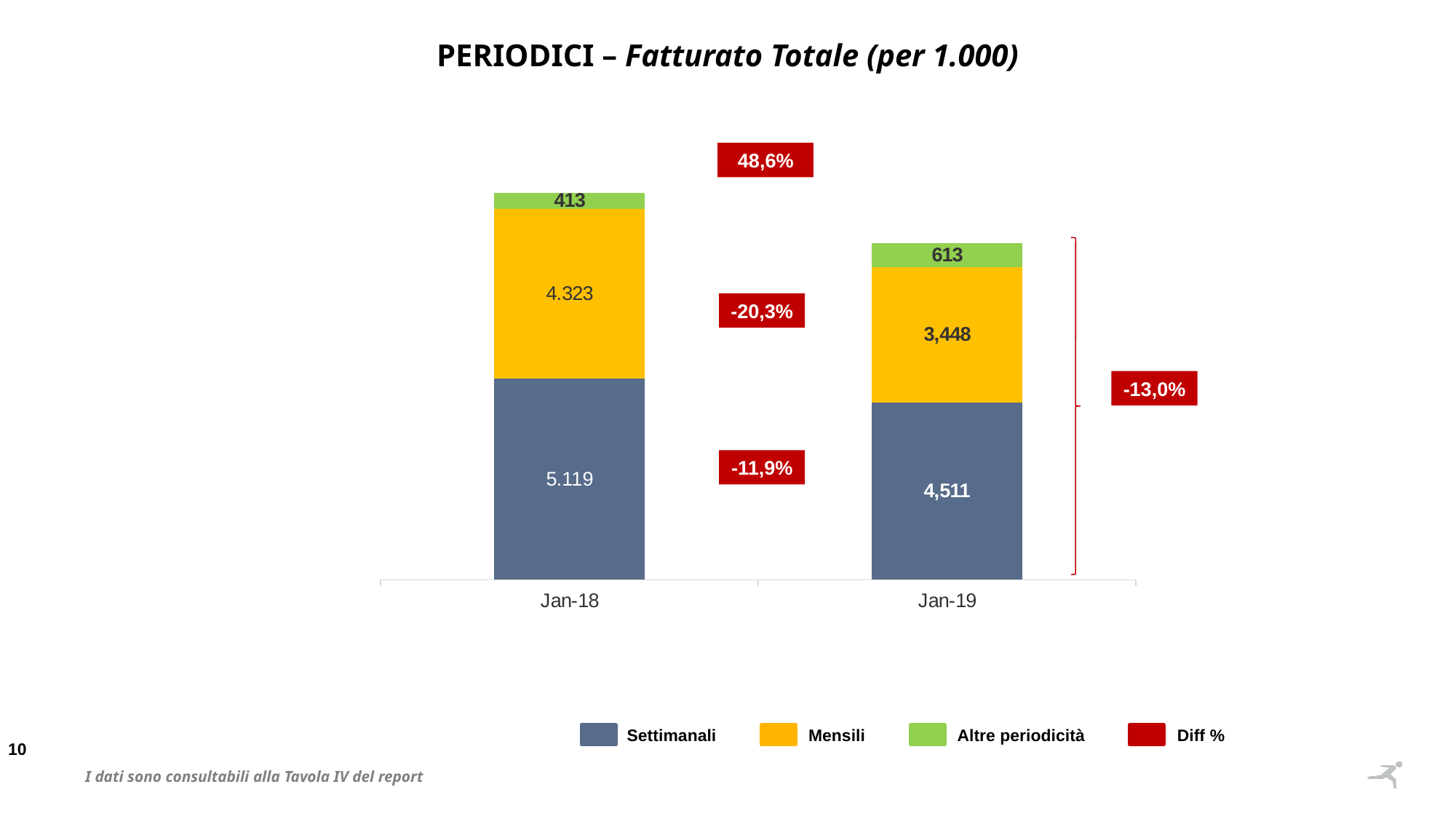
What is the Diff % shown for Mensili between Jan-18 and Jan-19? -20,3% What is the difference between the Settimanali values for Jan-18 and Jan-19? 608 How many categories are shown on the x axis? 2 What is the overall Diff % shown for the total between Jan-18 and Jan-19? -13,0% Is the Altre periodicità value larger in Jan-18 or Jan-19? Jan-19 What is the value for Settimanali in Jan-18? 5.119 Which series has the largest value in the Jan-19 bar? Settimanali Which series has the smallest value in the Jan-18 bar? Altre periodicità What is the value for Mensili in Jan-19? 3,448 How many series does the legend list? 4 What is the value for Altre periodicità in Jan-19? 613 What kind of chart is shown on the slide? Stacked bar chart